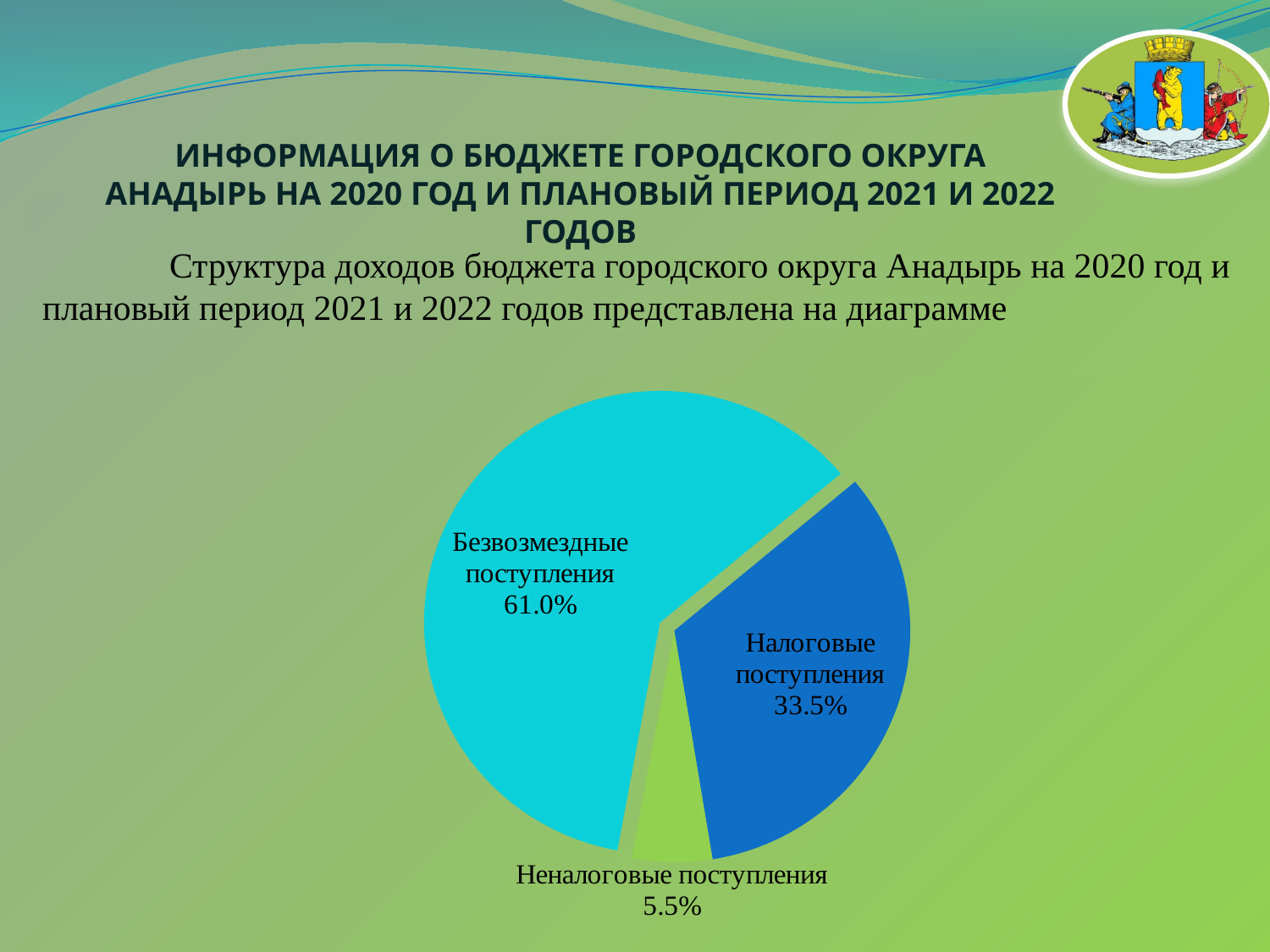
Which slice of the pie is the smallest? Неналоговые поступления What is the difference in percentage points between Безвозмездные поступления and Налоговые поступления? 27.5 What colour is the slice for Налоговые поступления? dark blue What share of the pie does Налоговые поступления have? 33.5% What share of the pie does Неналоговые поступления have? 5.5% What share of the pie does Безвозмездные поступления have? 61.0% What colour is the slice for Неналоговые поступления? green How many slices does the pie chart have? 3 What kind of chart is shown on the slide? pie chart Which is larger, Налоговые поступления or Неналоговые поступления? Налоговые поступления What is the difference in percentage points between Налоговые поступления and Неналоговые поступления? 28 Which slice of the pie is the largest? Безвозмездные поступления